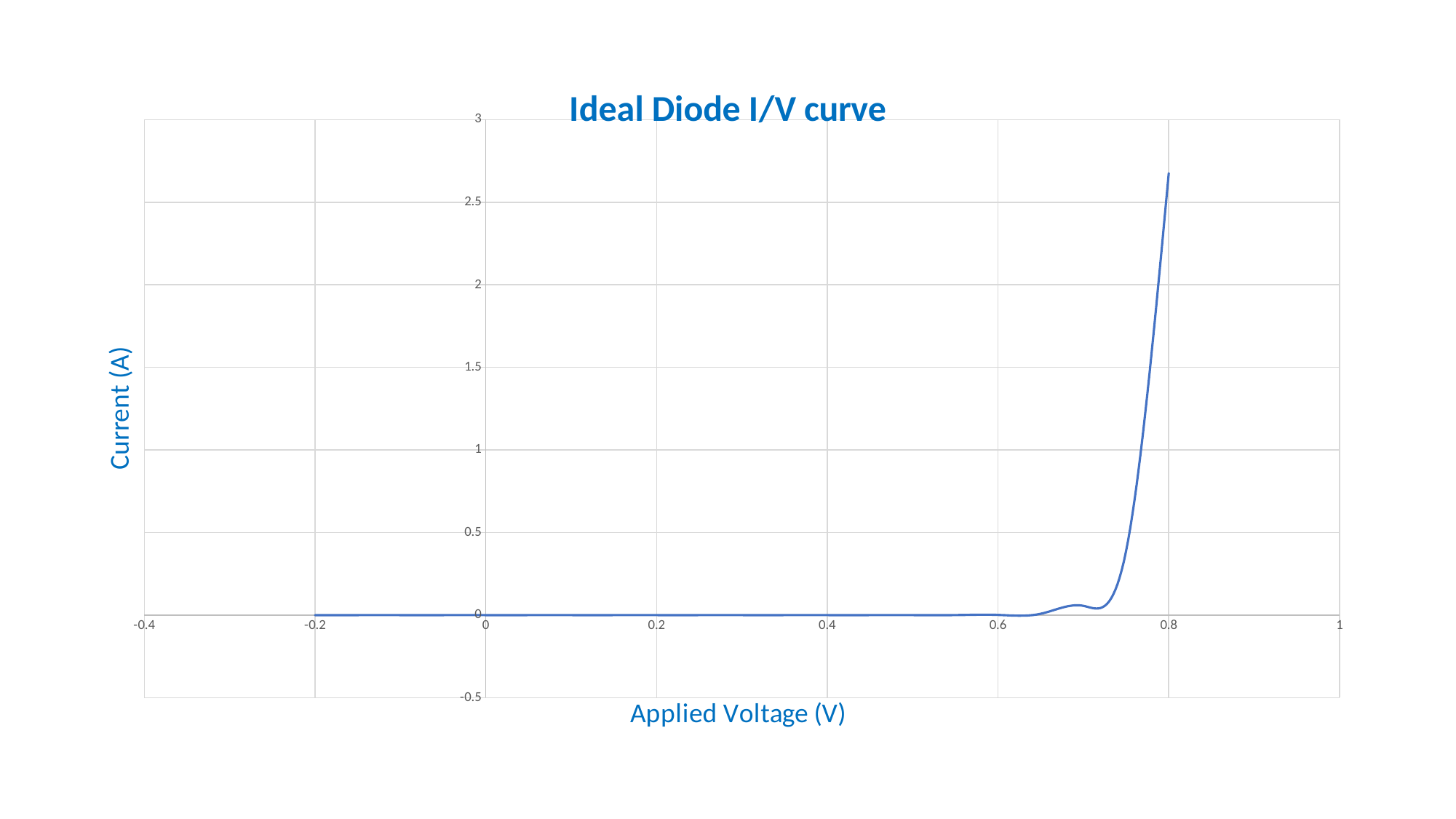
Is the current at an applied voltage of 0.2 V greater or less than 0.5? less Which is larger, the current at 0.8 V or the current at 0.4 V? 0.8 V At which labelled applied voltage on the x axis does the curve reach its highest current? 0.8 Is the current at an applied voltage of 0.6 V greater or less than 1? less Does the current rise or fall as the applied voltage increases from 0.6 V to 0.8 V? Rise What is the label of the vertical axis? Current (A) What kind of chart is shown on the slide? Line chart What is the highest value shown on the vertical axis? 3 Is the current at an applied voltage of 0.4 V greater or less than 0.5? less What is the title of the chart? Ideal Diode I/V curve